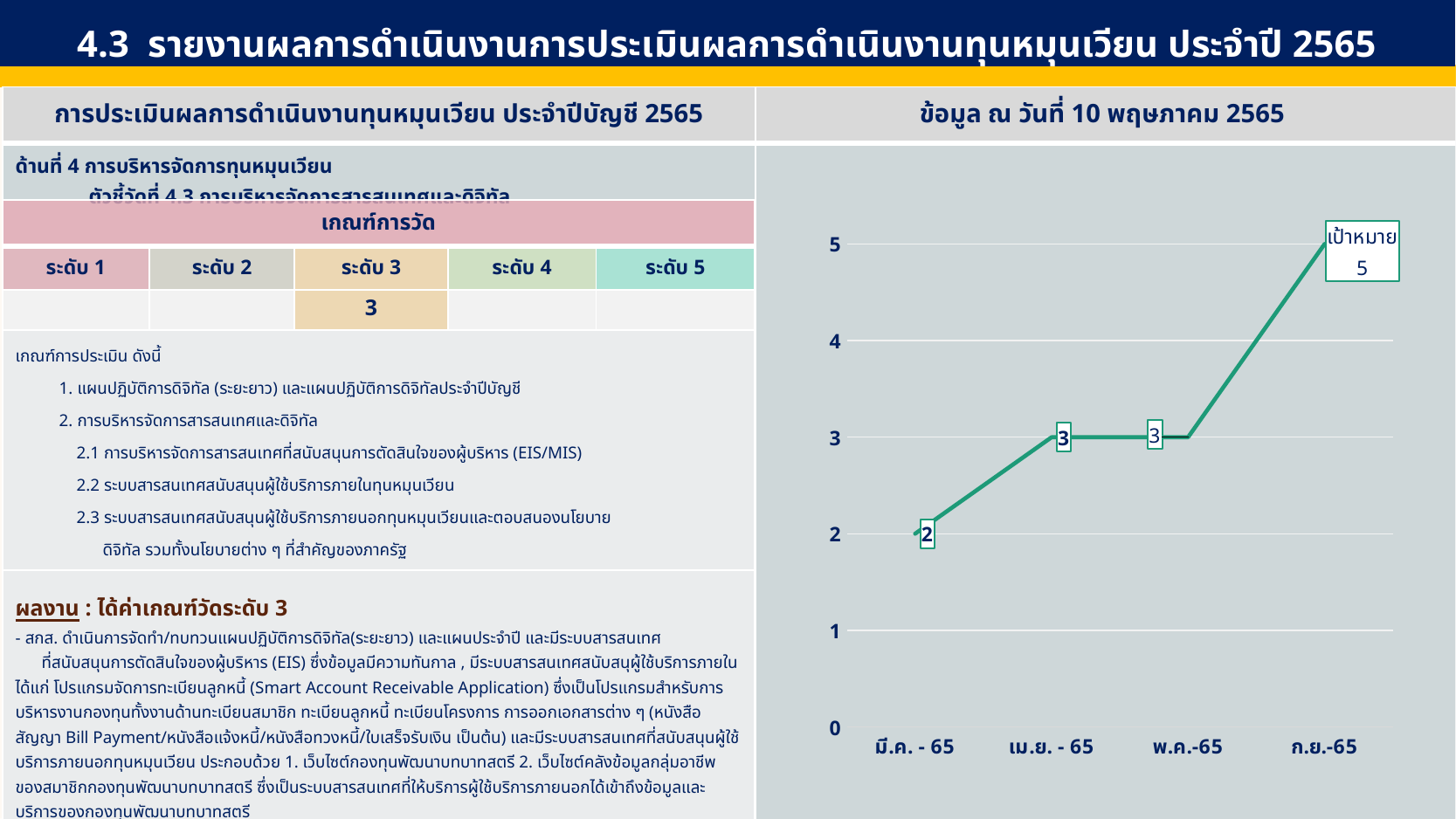
What type of chart is shown on the right side of the slide? line chart What is the value for ก.ย.-65 in the line chart? 5 What is the difference between the value for ก.ย.-65 and the value for มี.ค. - 65? 3 Do the values in the line chart rise or fall from มี.ค. - 65 to ก.ย.-65? rise Which category has the lowest value in the line chart? มี.ค. - 65 What is the value for เม.ย. - 65 in the line chart? 3 Which is larger, the value for เม.ย. - 65 or the value for มี.ค. - 65? เม.ย. - 65 What label is shown in the box next to the last point of the line chart? เป้าหมาย 5 What is the value for พ.ค.-65 in the line chart? 3 What is the value for มี.ค. - 65 in the line chart? 2 Which category has the highest value in the line chart? ก.ย.-65 How many categories are shown on the x axis of the line chart? 4